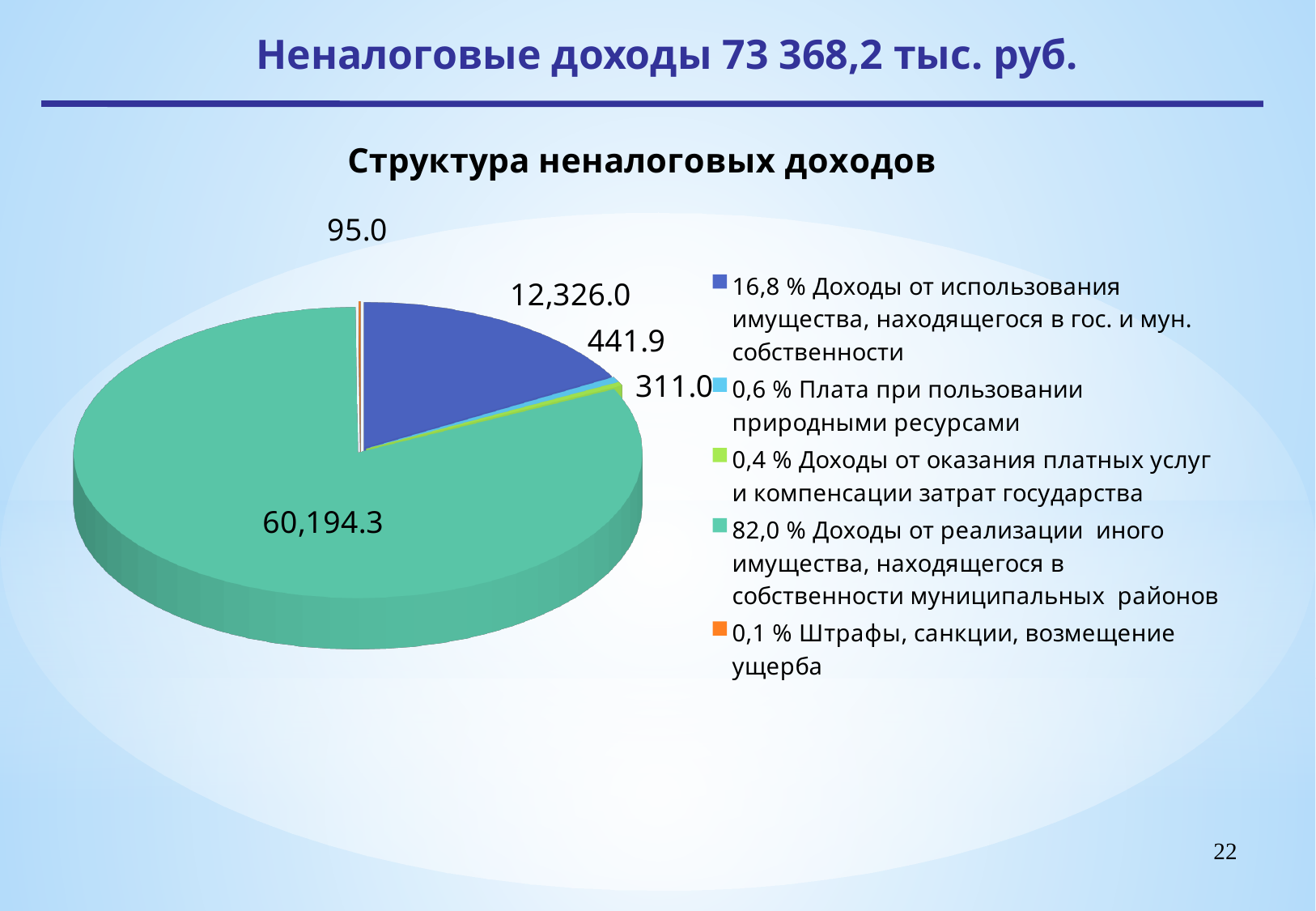
What kind of chart is shown on the slide? Pie chart What is the value of the slice for Доходы от реализации иного имущества, находящегося в собственности муниципальных районов? 60,194.3 What is the value of the slice for Плата при пользовании природными ресурсами? 441.9 Which category has the smallest slice of the pie? Штрафы, санкции, возмещение ущерба Which category has the largest slice of the pie? Доходы от реализации иного имущества, находящегося в собственности муниципальных районов Which is larger: the slice for Плата при пользовании природными ресурсами or the slice for Доходы от оказания платных услуг и компенсации затрат государства? Плата при пользовании природными ресурсами What is the value of the slice for Штрафы, санкции, возмещение ущерба? 95.0 What is the title of the chart? Структура неналоговых доходов How many entries does the legend list? 5 What share of the pie does Доходы от использования имущества, находящегося в гос. и мун. собственности represent, according to the legend? 16,8 % What is the value of the slice for Доходы от использования имущества, находящегося в гос. и мун. собственности? 12,326.0 How many slices does the pie chart have? 5